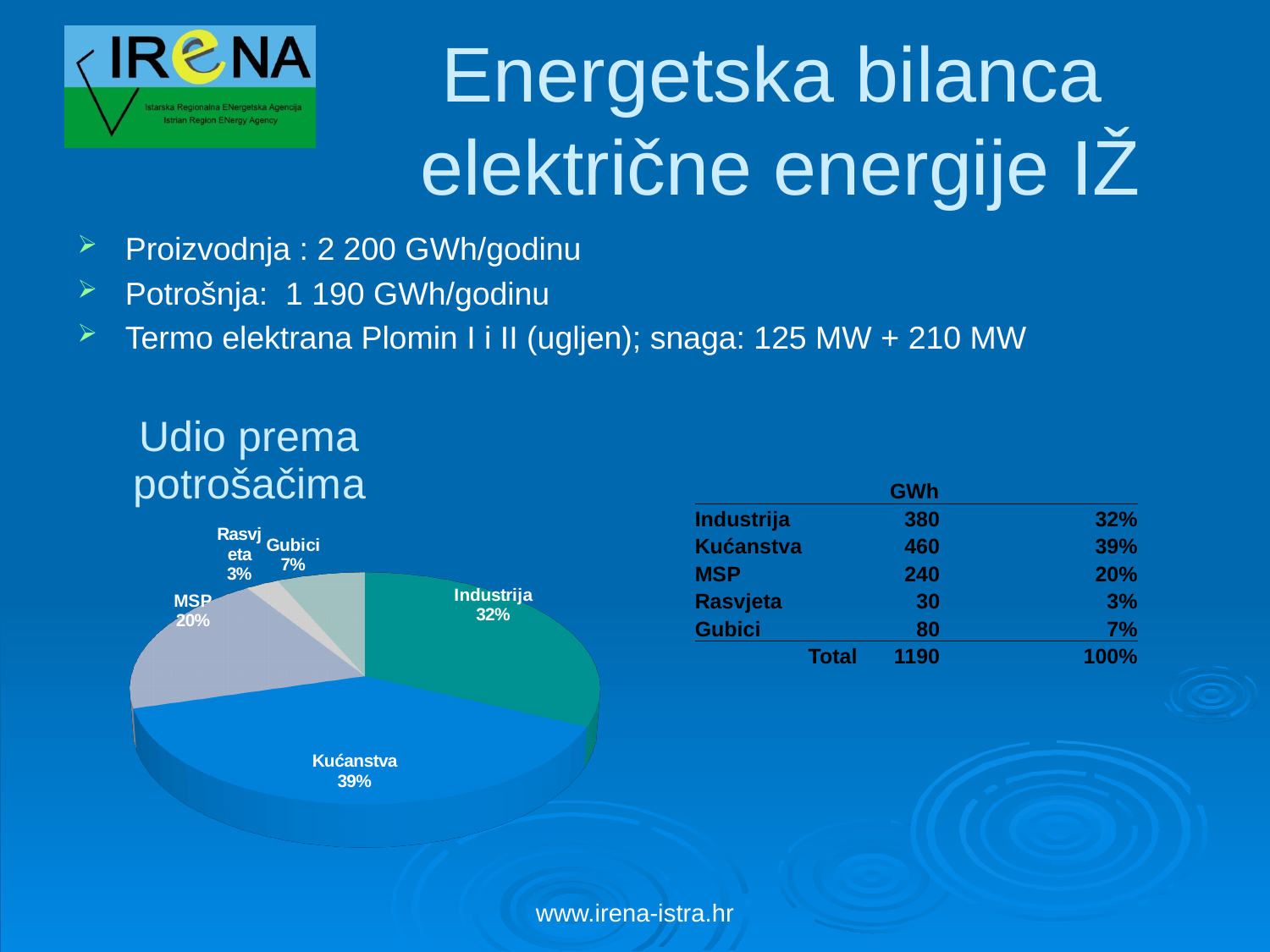
In the pie chart, what share does Kućanstva have? 39% In the pie chart, what share does Rasvjeta have? 3% Which slice of the pie chart is the largest? Kućanstva In the pie chart, what is the difference in percentage points between the Gubici share and the Rasvjeta share? 4 In the pie chart, what share does Gubici have? 7% How many slices does the pie chart have? 5 Which slice of the pie chart is the smallest? Rasvjeta In the pie chart, which is larger: the share for Industrija or the share for MSP? Industrija What kind of chart is shown under the heading "Udio prema potrošačima"? pie chart In the pie chart, what is the difference in percentage points between the Kućanstva share and the Industrija share? 7 In the pie chart, what share does MSP have? 20% In the pie chart, what share does Industrija have? 32%